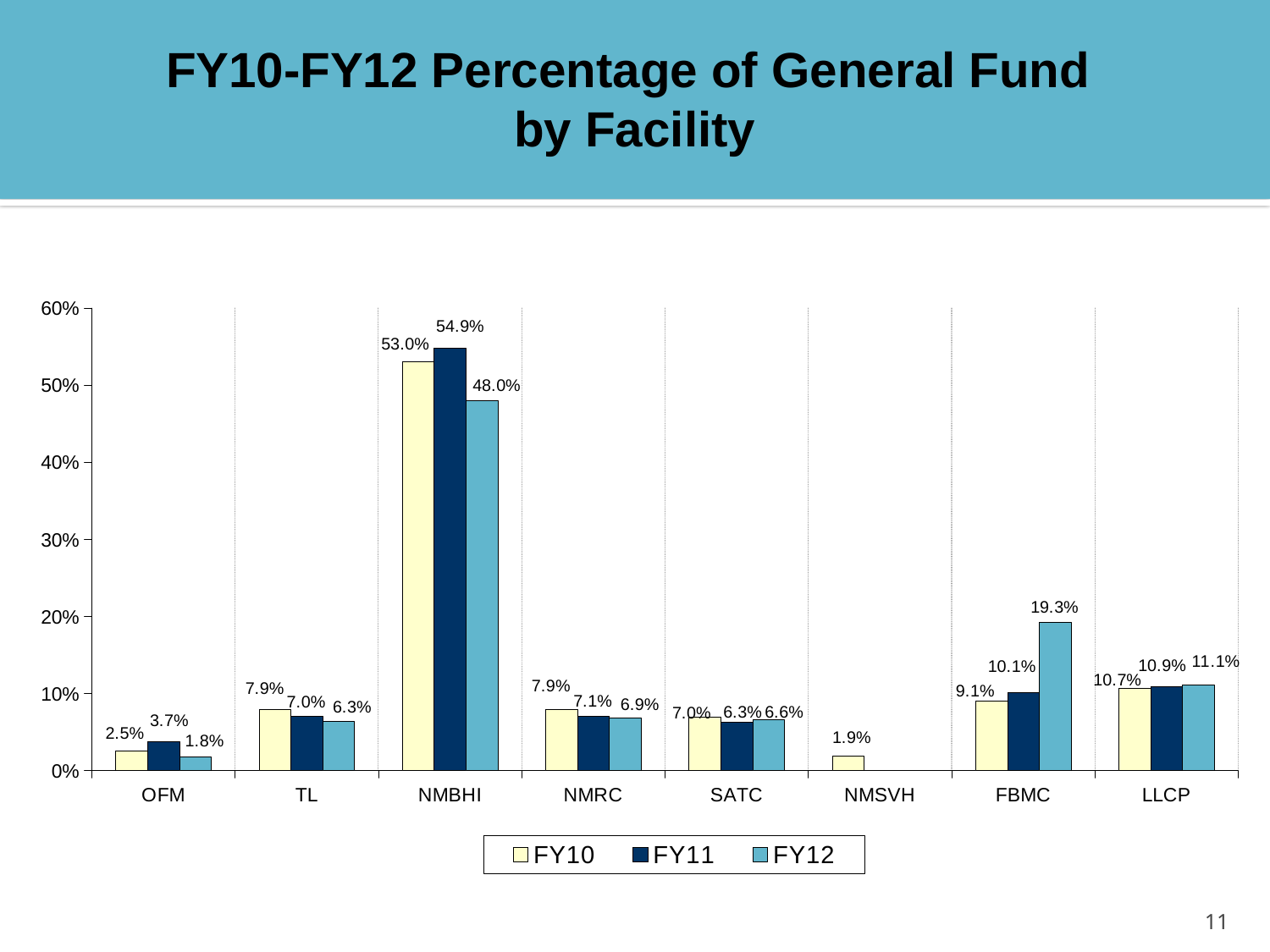
What is the FY11 value for NMBHI? 54.9% What is the difference between the FY11 and FY12 values for NMBHI? 6.9% How many facilities are shown on the x axis? 8 What is the FY10 value for OFM? 2.5% Which is larger for LLCP, the FY10 value or the FY12 value? FY12 What kind of chart is shown on the slide? bar chart Do the values for FBMC rise or fall from FY10 to FY12? rise Is the FY10 value for NMBHI greater or less than 50%? greater Which facility has the highest FY12 value? NMBHI How many series does the legend list? 3 What is the FY12 value for FBMC? 19.3%